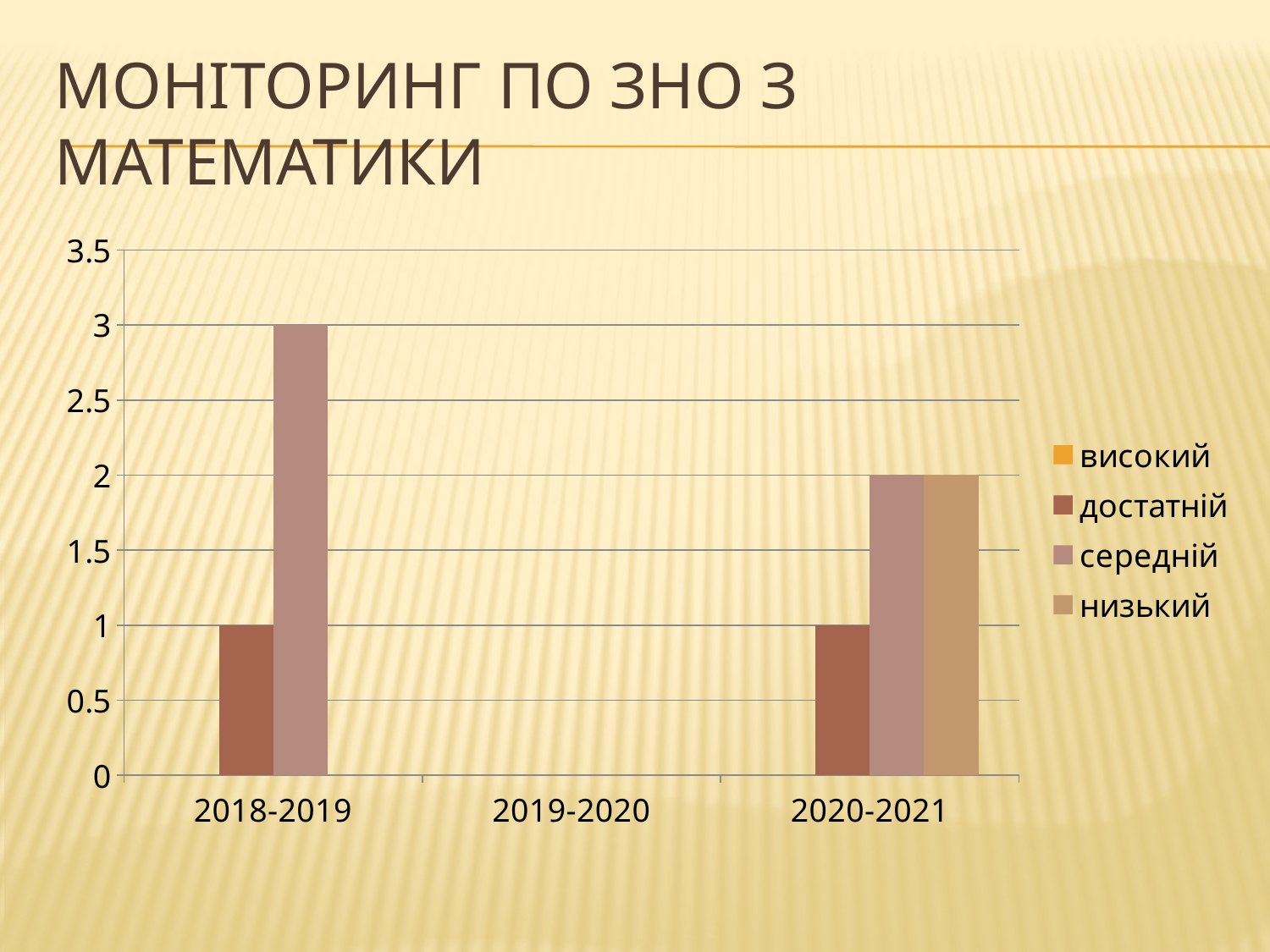
What is the title of the slide containing the chart? МОНІТОРИНГ ПО ЗНО З МАТЕМАТИКИ How many categories are shown on the x axis? 3 What is the value for середній in 2020-2021? 2 What kind of chart is shown on the slide? bar chart What is the difference between середній in 2018-2019 and середній in 2020-2021? 1 What is the value for низький in 2020-2021? 2 How many series does the legend list? 4 Is the value for середній in 2018-2019 greater or less than 2.5? greater What is the value for достатній in 2018-2019? 1 Which is larger: середній in 2018-2019 or низький in 2020-2021? середній in 2018-2019 Which category has the highest bar on the chart? 2018-2019 What is the value for середній in 2018-2019? 3